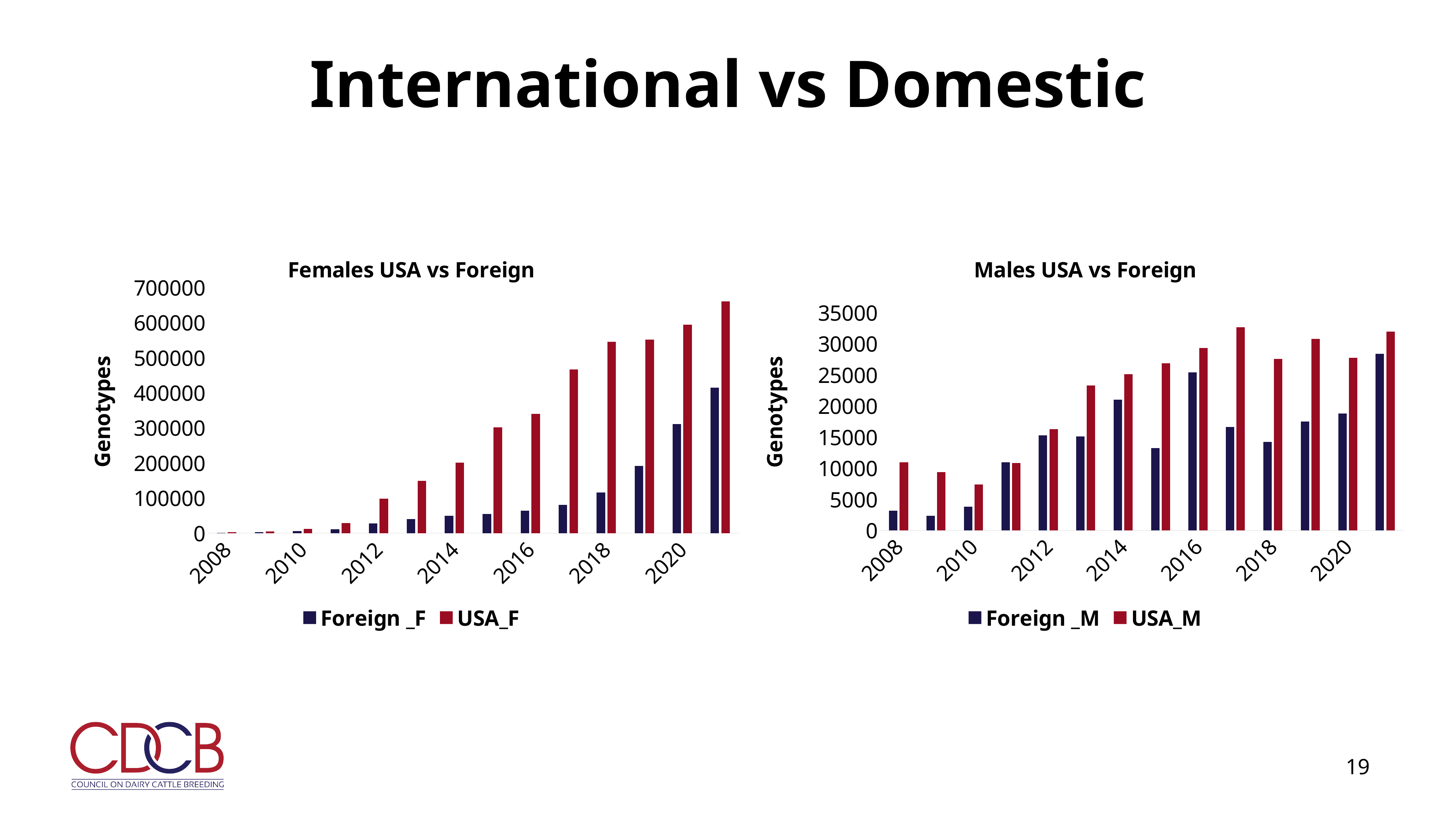
In the "Females USA vs Foreign" chart, is the USA_F value for 2020 greater or less than 500000? greater In the "Females USA vs Foreign" chart, which year has the highest USA_F value? 2021 What type of chart is the "Females USA vs Foreign" chart? bar chart How many series does the legend of the "Males USA vs Foreign" chart list? 2 In the "Males USA vs Foreign" chart, which is larger in 2016, Foreign _M or USA_M? USA_M In the "Males USA vs Foreign" chart, is the USA_M value for 2010 greater or less than 10000? less In the "Males USA vs Foreign" chart, is the Foreign _M value for 2008 greater or less than 5000? less In the "Females USA vs Foreign" chart, what are the two legend entries? Foreign _F and USA_F What is the y-axis label on the "Males USA vs Foreign" chart? Genotypes In the "Females USA vs Foreign" chart, do the USA_F values rise or fall from 2008 to 2021? rise